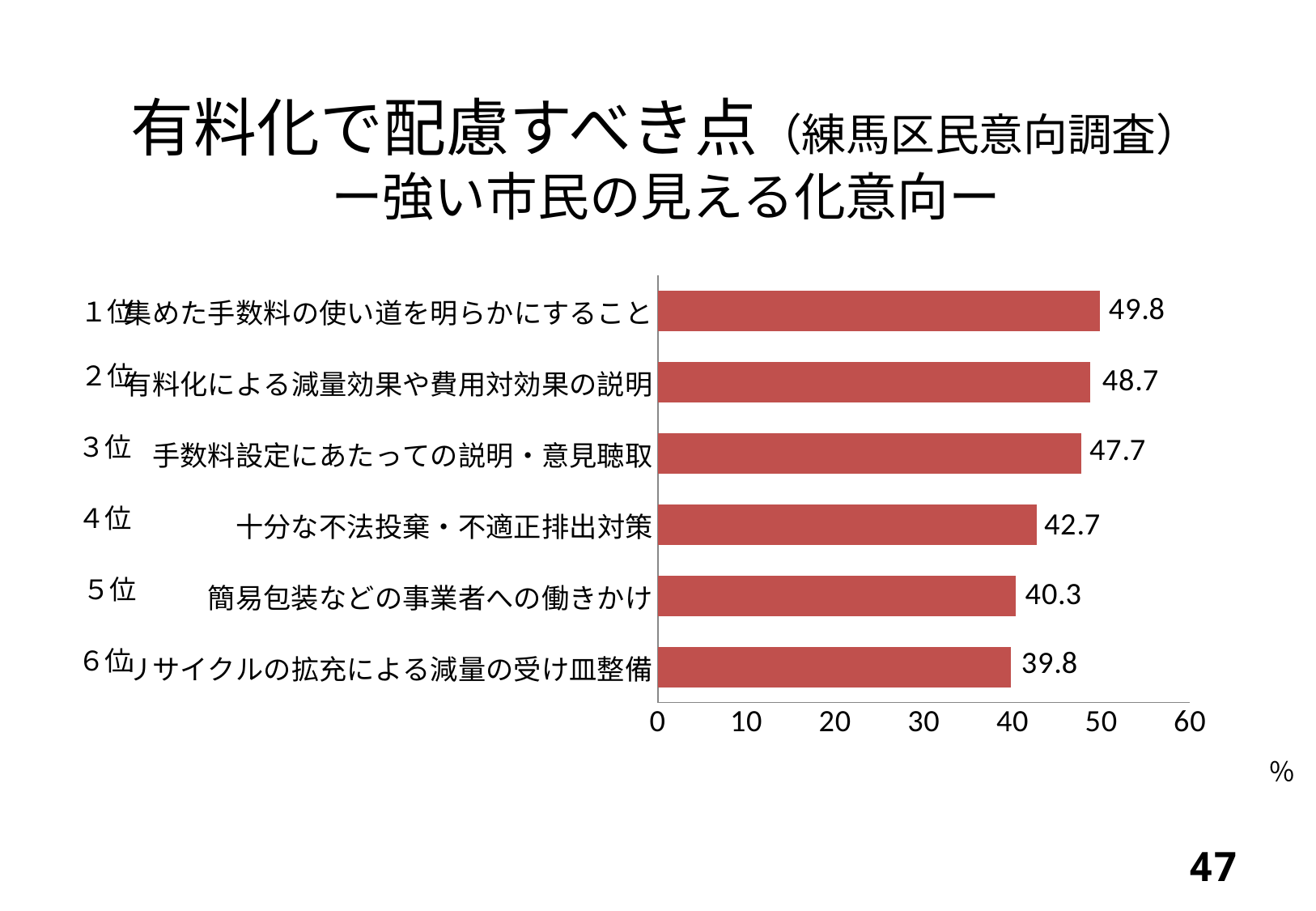
How many categories are shown in the chart? 6 Which category has the highest value? 集めた手数料の使い道を明らかにすること What is the value for 十分な不法投棄・不適正排出対策? 42.7 Which category has the lowest value? リサイクルの拡充による減量の受け皿整備 What is the value for リサイクルの拡充による減量の受け皿整備? 39.8 Is the value for 簡易包装などの事業者への働きかけ greater or less than 50? less Which is larger, the value for 手数料設定にあたっての説明・意見聴取 or the value for 十分な不法投棄・不適正排出対策? 手数料設定にあたっての説明・意見聴取 What is the value for 集めた手数料の使い道を明らかにすること? 49.8 What kind of chart is shown on the slide? bar chart What is the difference between the values for 有料化による減量効果や費用対効果の説明 and 簡易包装などの事業者への働きかけ? 8.4 What unit is indicated for the values in the chart? % What is the difference between the highest and lowest values in the chart? 10.0